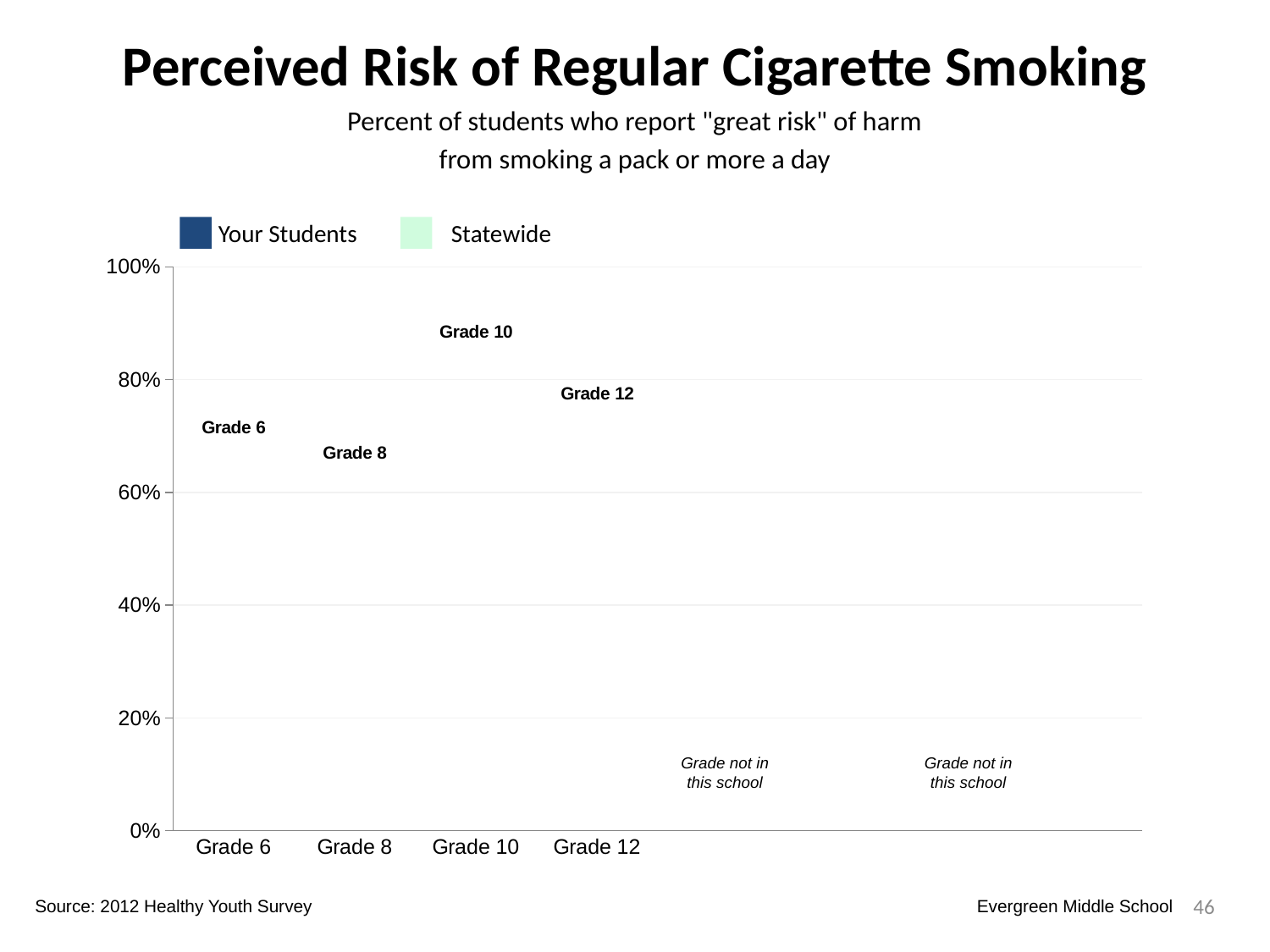
What is the highest value shown on the y axis? 100% How many times does the note "Grade not in this school" appear on the chart? 2 How many grade categories are labelled along the x axis? 4 Which grade is listed first on the x axis? Grade 6 Which grade is listed last on the x axis? Grade 12 What are the two series named in the legend? Your Students and Statewide What is the lowest value shown on the y axis? 0% How many series does the legend list? 2 What note appears in the chart area to the right of the Grade 12 category? Grade not in this school What is the title of the chart? Perceived Risk of Regular Cigarette Smoking